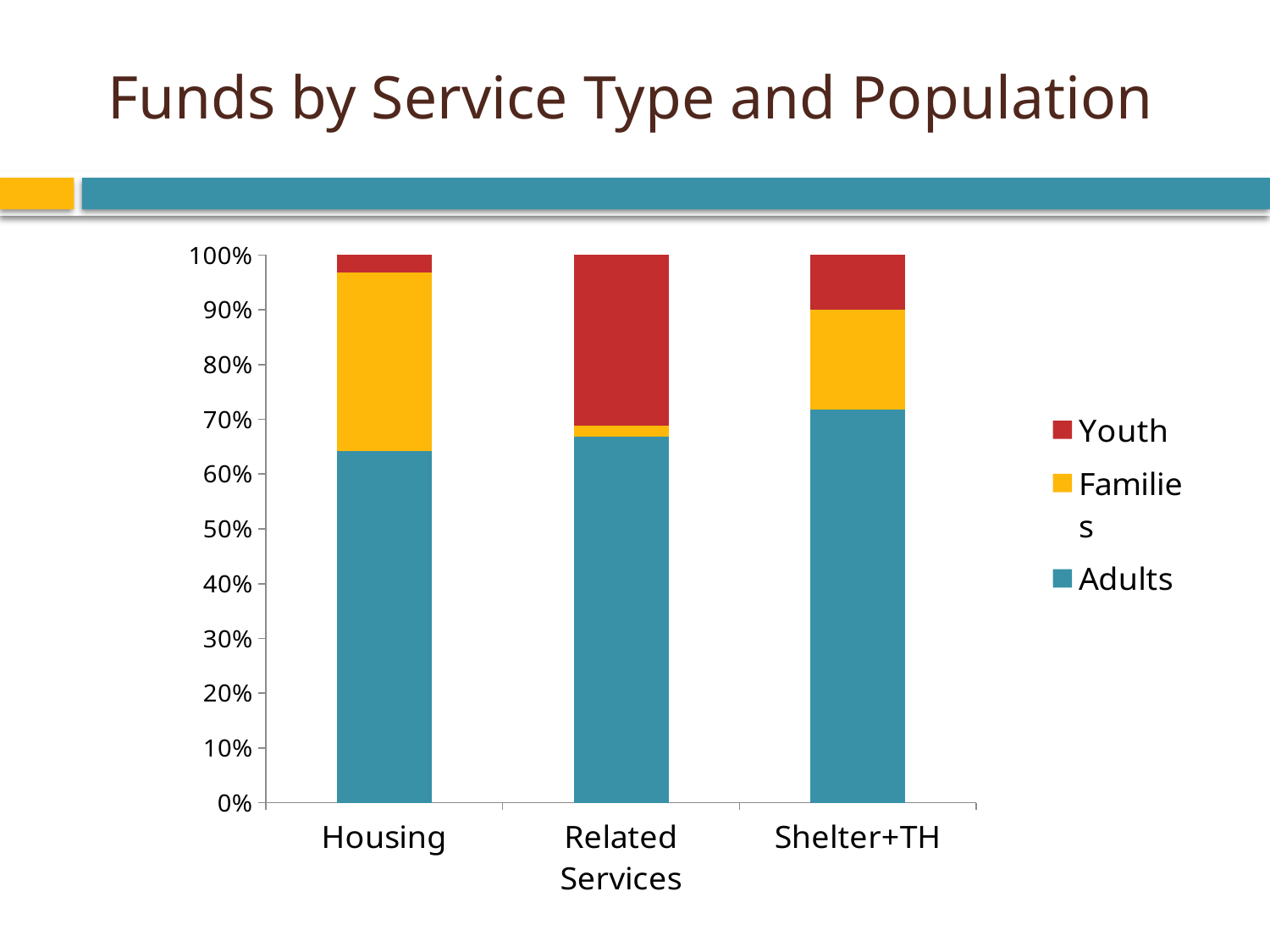
Which is larger for Shelter+TH, the Families share or the Youth share? Families Which service type has the largest Youth share? Related Services Is the Adults share for Housing greater or less than 60%? greater What is the title of the slide? Funds by Service Type and Population What kind of chart is shown on the slide? stacked bar chart Which service type has the smallest Families share? Related Services Is the Adults share for Related Services greater or less than 70%? less Which colour represents Youth in the chart? red Which service type has the largest Families share? Housing How many service type categories are shown on the x axis? 3 Is the Adults share for Shelter+TH greater or less than 70%? greater How many series does the legend list? 3